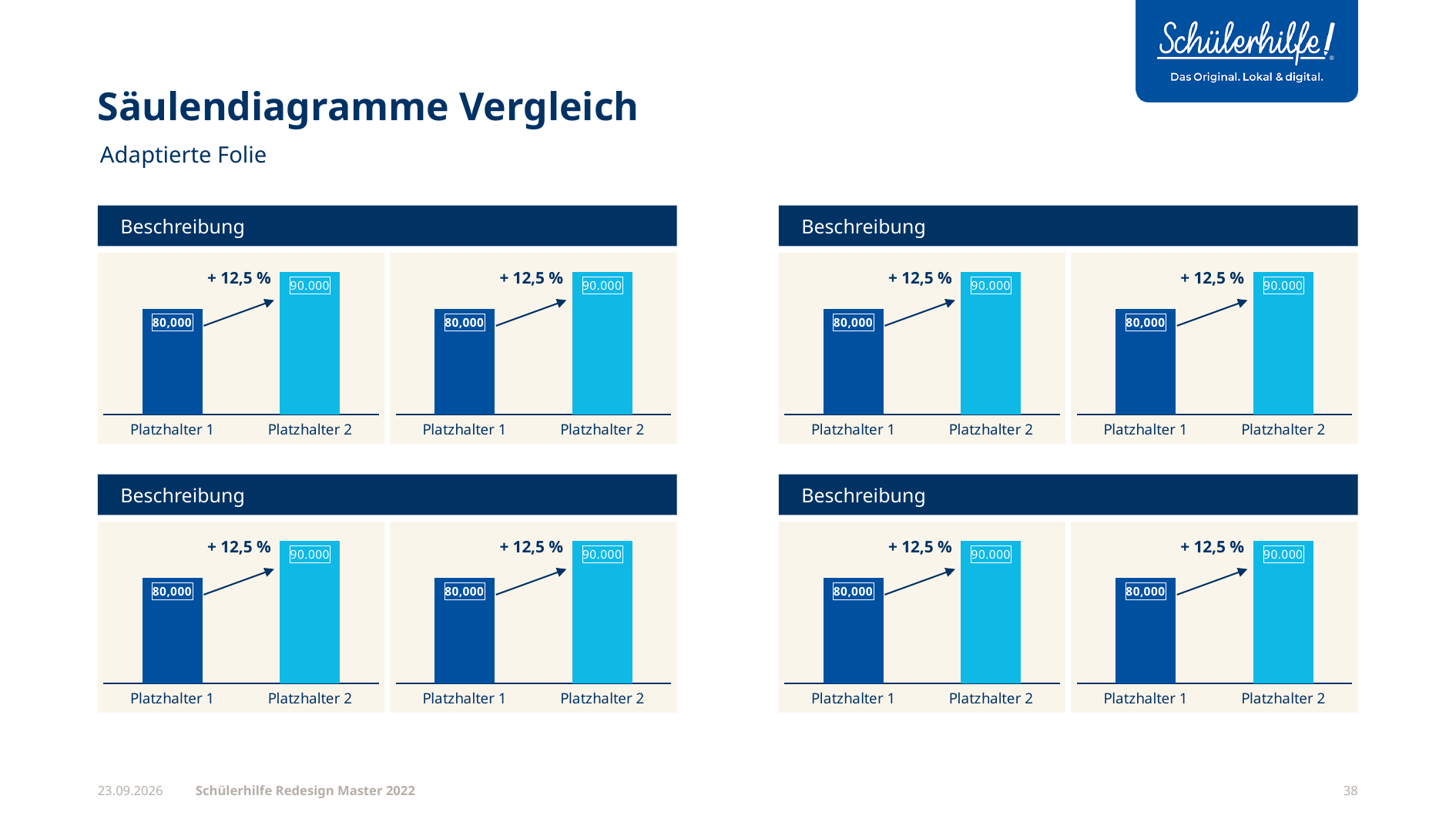
In the top-left chart, which category has the lowest value? Platzhalter 1 What kind of chart is shown in the top-left panel of the slide? bar chart In the top-left chart, which category has the highest value? Platzhalter 2 What percentage change is annotated above the arrow in the top-left chart? + 12,5 % How many categories are shown on the x axis of the top-left chart? 2 What is the header text shown above each group of charts? Beschreibung In the bottom-right chart, what is the value for Platzhalter 1? 80,000 In the top-left chart, do the values rise or fall from Platzhalter 1 to Platzhalter 2? rise In the bottom-right chart, which is larger, Platzhalter 1 or Platzhalter 2? Platzhalter 2 In the top-left chart, what is the value for Platzhalter 1? 80,000 How many small bar charts are shown on the slide in total? 8 In the top-left chart, what is the value for Platzhalter 2? 90.000